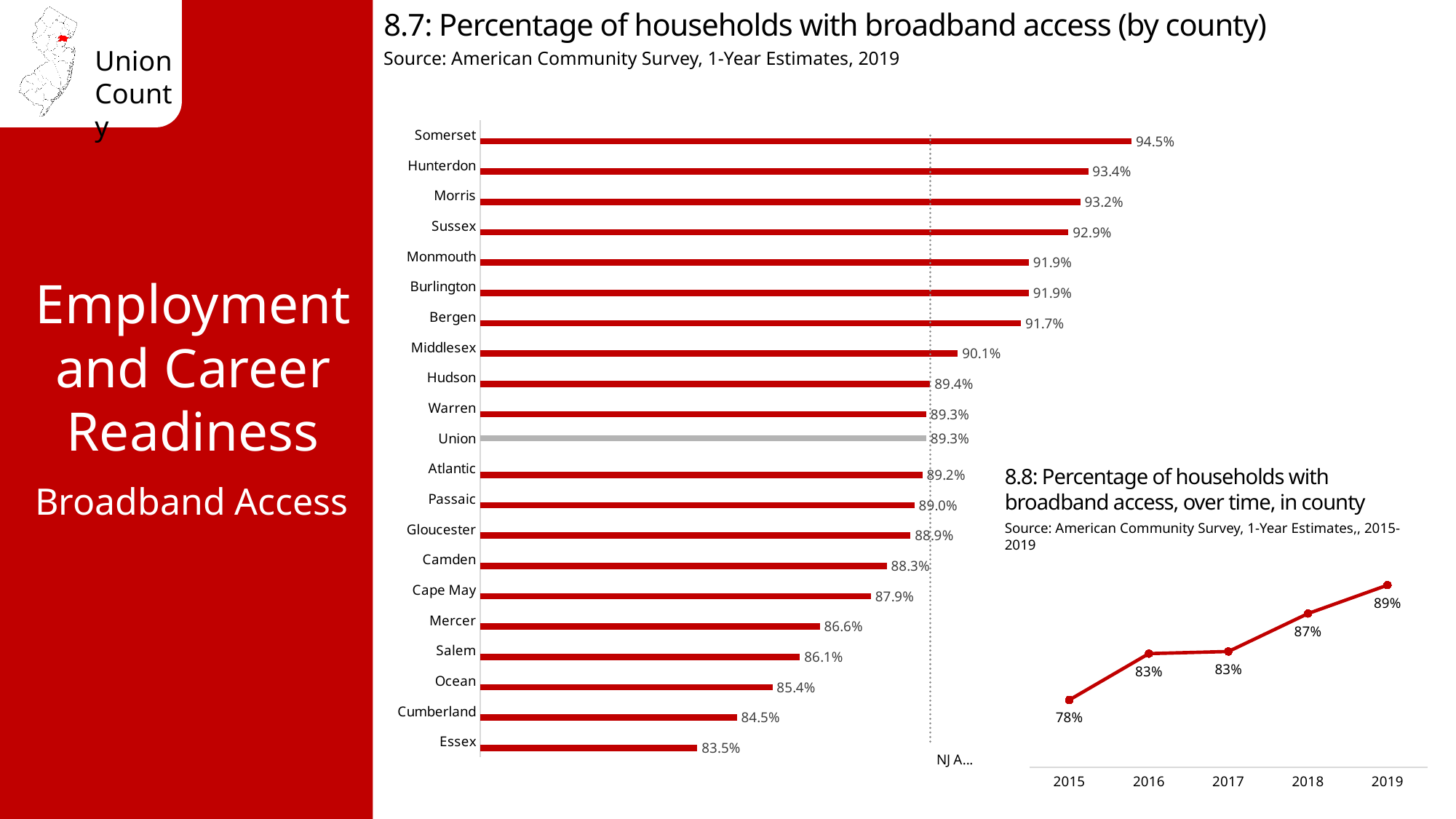
In chart 8.7, what is the difference between Somerset's and Essex's percentages? 11.0% How many data points are plotted in chart 8.8? 5 How many counties are shown in chart 8.7? 21 In chart 8.8, what was the percentage of households with broadband access in 2015? 78% In chart 8.7, what is the value for Cumberland? 84.5% What type of chart is chart 8.7? Bar chart In chart 8.8, what is the difference between the 2019 and 2015 values? 11% In chart 8.8, do the values generally rise or fall from 2015 to 2019? Rise In chart 8.7, which county has a higher percentage of households with broadband access, Bergen or Mercer? Bergen In chart 8.7, which county has the highest percentage of households with broadband access? Somerset In chart 8.7, which county has the lowest percentage of households with broadband access? Essex In chart 8.7, what percentage of households in Union County have broadband access? 89.3%